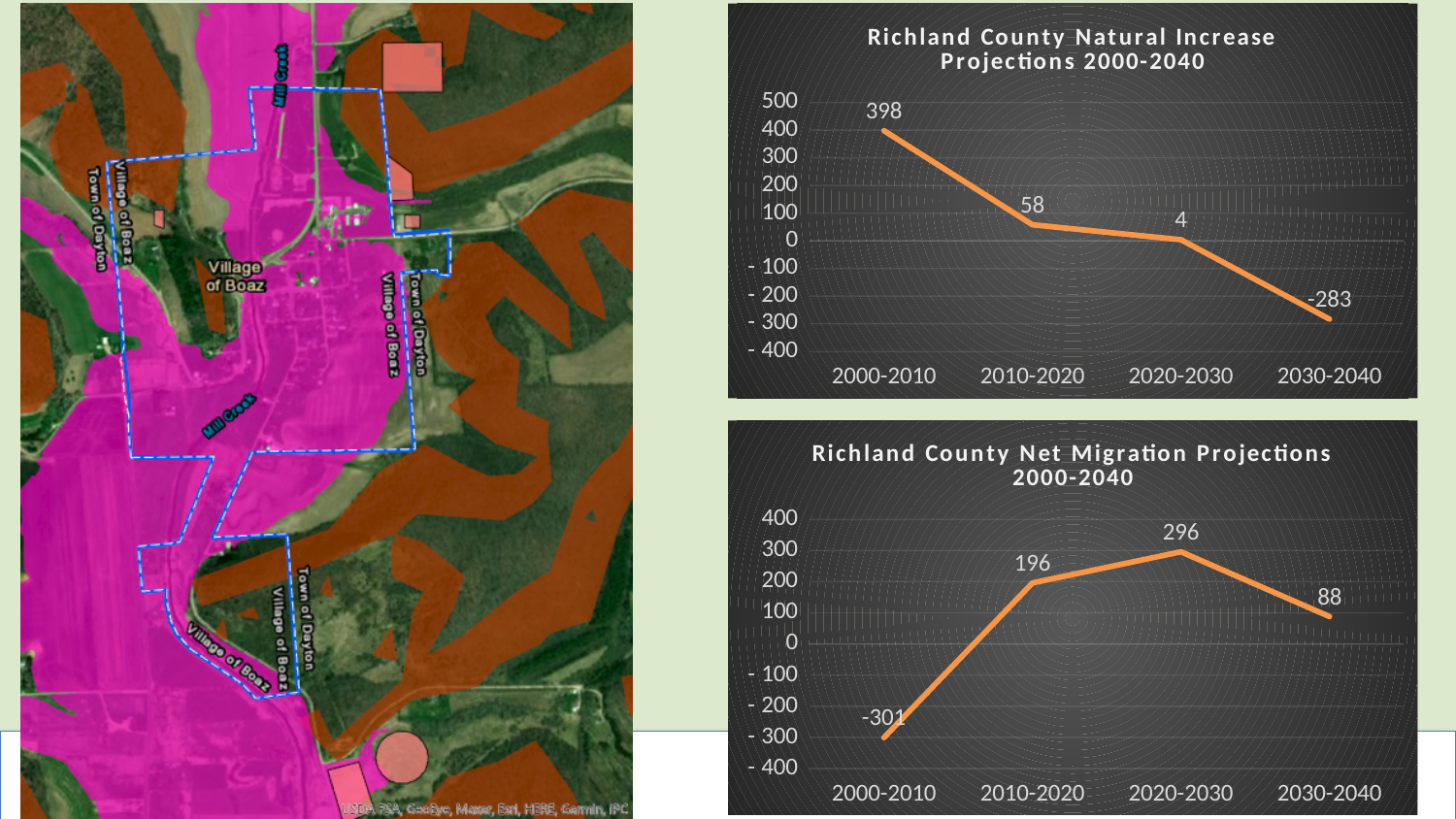
In the 'Richland County Net Migration Projections 2000-2040' chart, which is larger, the value for 2010-2020 or the value for 2030-2040? 2010-2020 In the 'Richland County Net Migration Projections 2000-2040' chart, what is the value for 2000-2010? -301 In the 'Richland County Natural Increase Projections 2000-2040' chart, which period has the lowest value? 2030-2040 In the 'Richland County Natural Increase Projections 2000-2040' chart, do the values rise or fall from 2000-2010 to 2030-2040? fall In the 'Richland County Natural Increase Projections 2000-2040' chart, what is the value for 2030-2040? -283 In the 'Richland County Natural Increase Projections 2000-2040' chart, what is the value for 2000-2010? 398 In the 'Richland County Net Migration Projections 2000-2040' chart, which period has the highest value? 2020-2030 In the 'Richland County Natural Increase Projections 2000-2040' chart, how many periods are plotted? 4 In the 'Richland County Net Migration Projections 2000-2040' chart, what is the difference between the 2020-2030 and 2030-2040 values? 208 What type of chart is the 'Richland County Net Migration Projections 2000-2040' chart? line chart In the 'Richland County Natural Increase Projections 2000-2040' chart, what is the difference between the 2010-2020 and 2020-2030 values? 54 In the 'Richland County Net Migration Projections 2000-2040' chart, what is the value for 2020-2030? 296